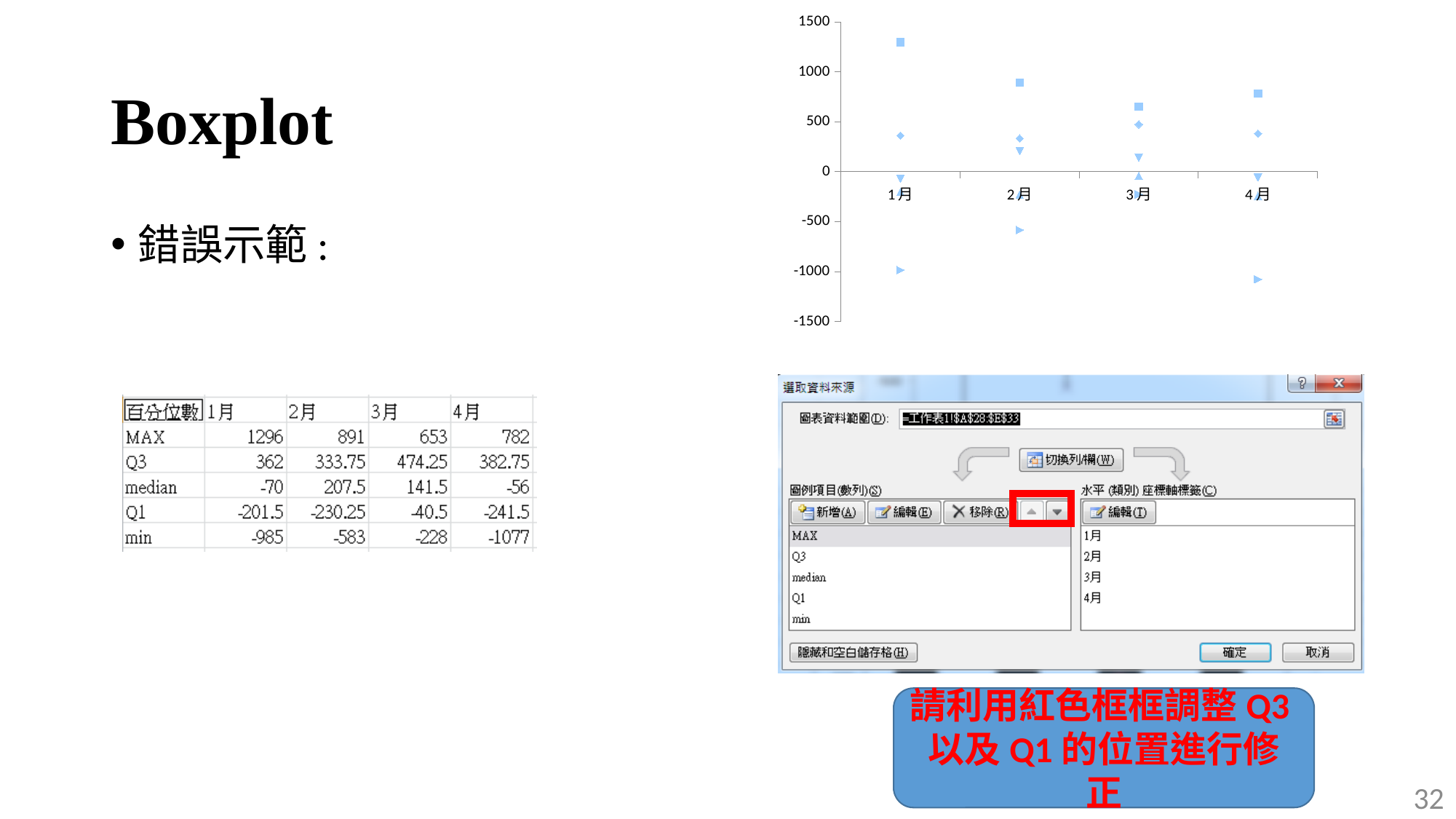
Which is lower, the bottommost point for 1月 or the bottommost point for 3月? 1月 Is the highest point for 3月 greater or less than 500? greater How many month categories are shown on the x axis of the chart? 4 Is the lowest point for 1月 greater or less than -500? less Which month has the highest plotted point in the chart? 1月 What is the maximum value shown on the chart's vertical axis? 1500 What is the minimum value shown on the chart's vertical axis? -1500 Which is higher, the topmost point for 1月 or the topmost point for 2月? 1月 Is the highest point for 2月 greater or less than 1000? less What kind of chart is shown at the top right of the slide? scatter plot